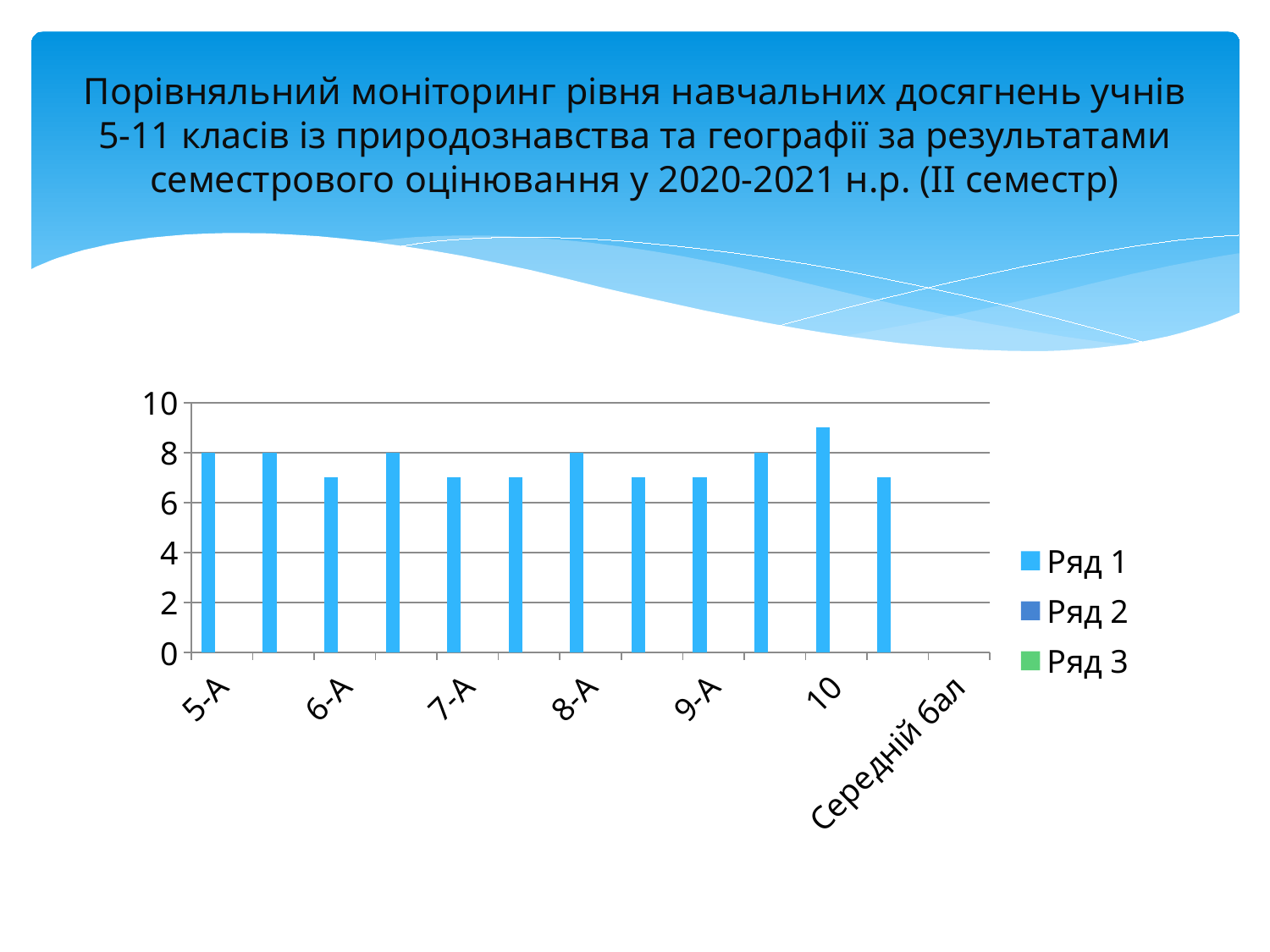
Which is larger, the value for 10 or the value for 9-А? 10 Is the value for 9-А greater or less than 8? less How many series does the legend list? 3 Is the value for 10 greater or less than 8? greater What is the value for 5-А? 8 What is the value for 8-А? 8 What kind of chart is shown on the slide? bar chart Which is larger, the value for 5-А or the value for 6-А? 5-А Which labelled category has the highest bar? 10 Is the value for 7-А greater or less than 6? greater What are the legend entries of the chart? Ряд 1, Ряд 2, Ряд 3